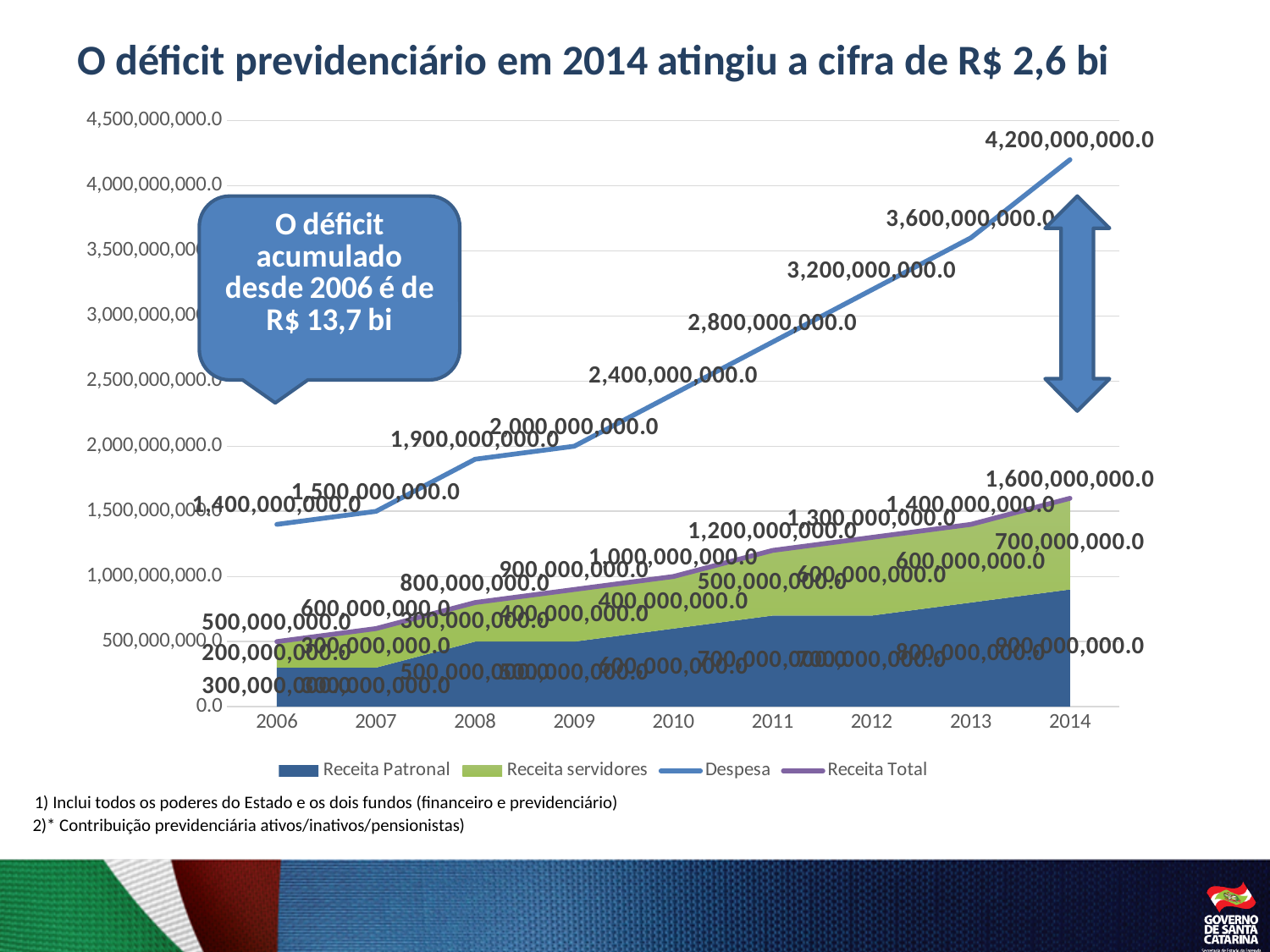
How many years are shown on the x axis? 9 In which year is Despesa highest? 2014 What is the Receita servidores value for 2014? 700,000,000.0 What is the Receita Total value for 2014? 1,600,000,000.0 What is the difference between the Despesa values for 2013 and 2012? 400,000,000.0 What is the Despesa value for 2010? 2,400,000,000.0 Does Despesa rise or fall from 2006 to 2014? rise What is the Despesa value for 2014? 4,200,000,000.0 In which year is Despesa lowest? 2006 What is the Despesa value for 2006? 1,400,000,000.0 What is the difference between Despesa and Receita Total in 2014? 2,600,000,000.0 How many series does the legend list? 4